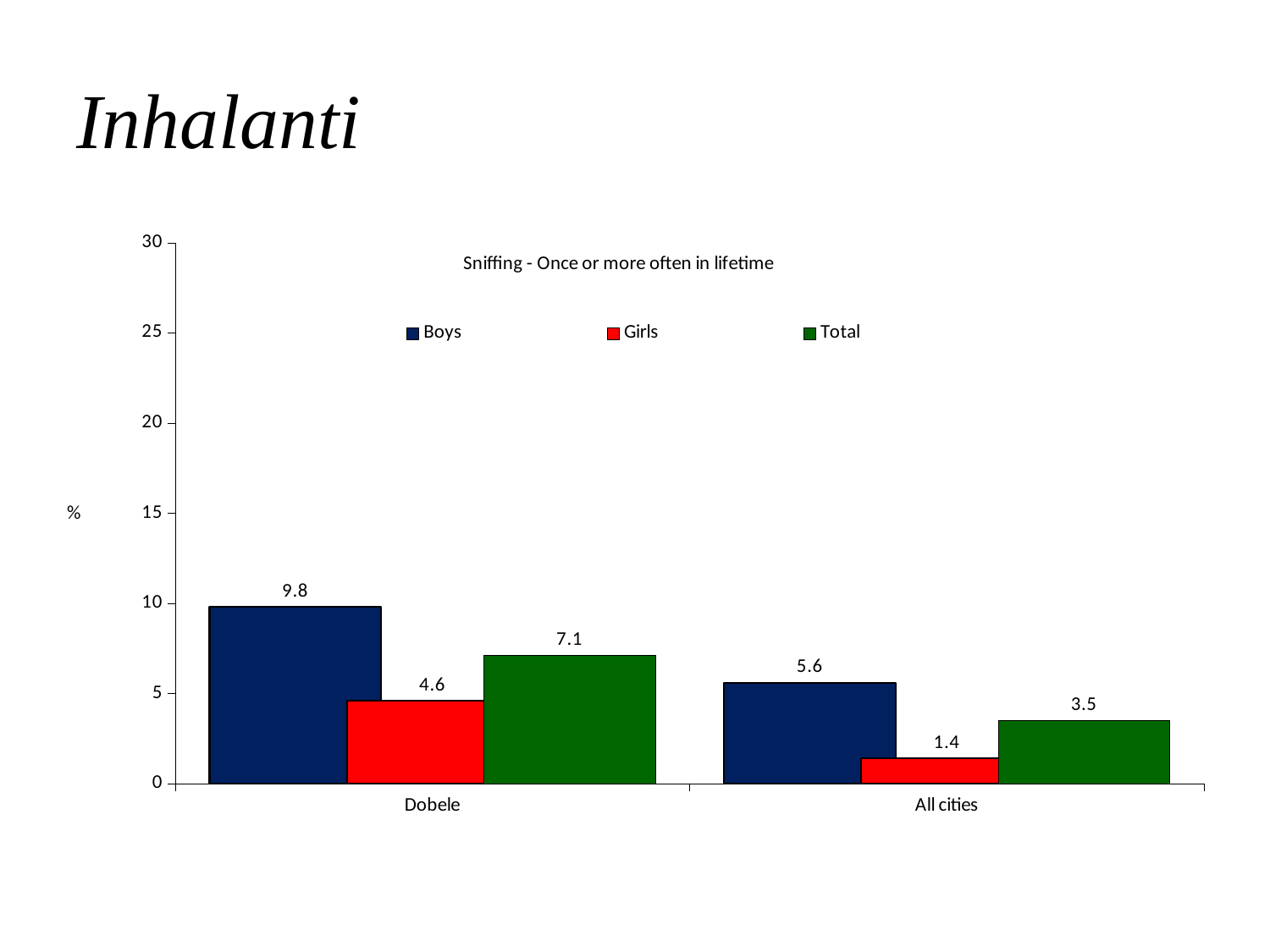
What is the difference between the Boys values for Dobele and All cities? 4.2 What kind of chart is shown on the slide? bar chart How many categories are shown on the x axis? 2 What is the value for Girls in All cities? 1.4 Which series has the lowest value in All cities? Girls How many series does the legend list? 3 Which is larger, the Girls value in Dobele or the Girls value in All cities? Dobele What is the value for Total in Dobele? 7.1 Is the value for Boys in Dobele greater or less than 5? greater Which series has the highest value in Dobele? Boys What is the value for Boys in Dobele? 9.8 What is the value for Total in All cities? 3.5